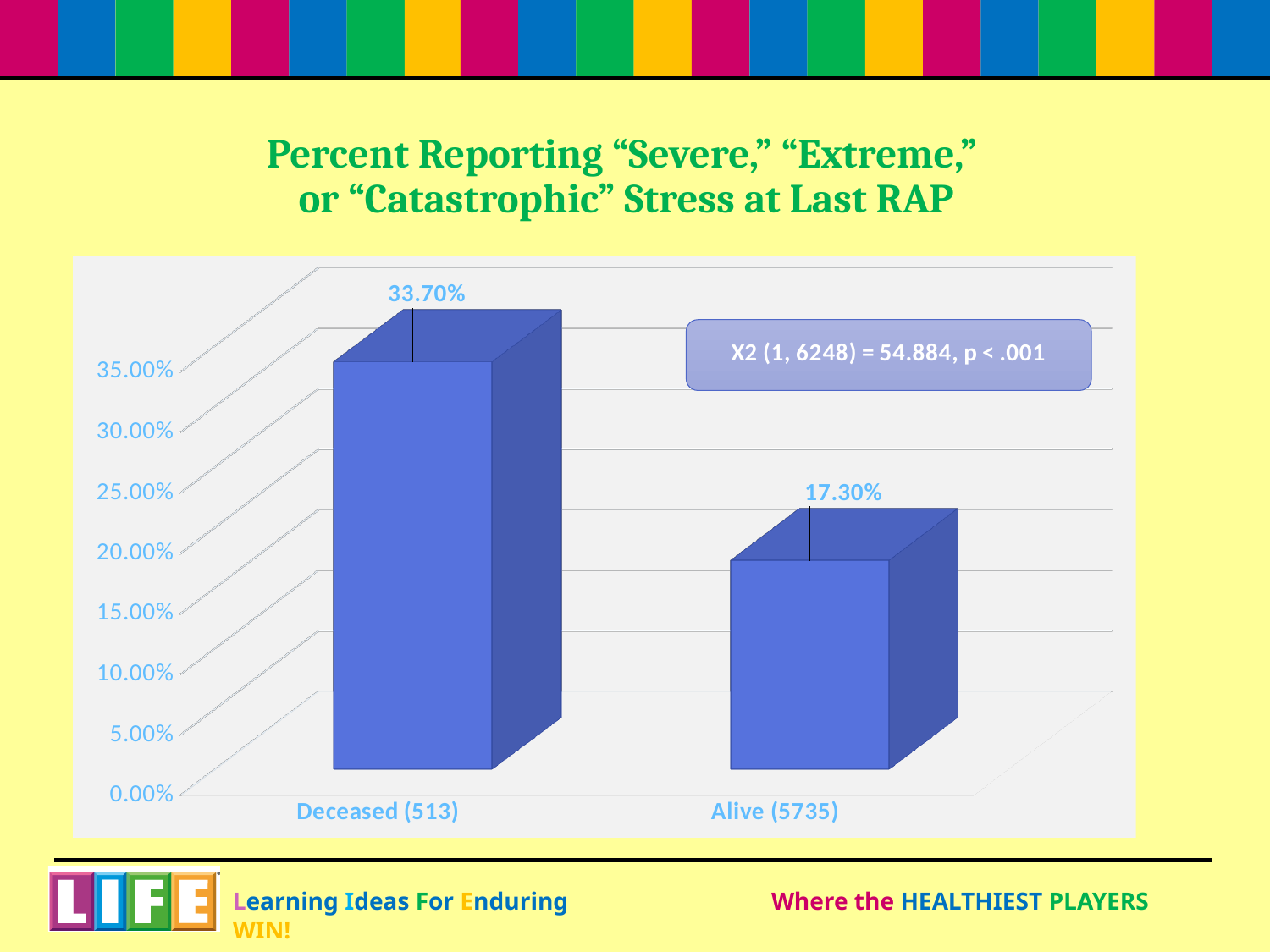
Which group has the lower percentage reporting severe, extreme, or catastrophic stress? Alive (5735) Is the value for Deceased (513) greater or less than 30.00%? greater What percentage is shown for the Alive (5735) group? 17.30% Is the value for Alive (5735) greater or less than 20.00%? less What percentage is shown for the Deceased (513) group? 33.70% Which group has the higher percentage reporting severe, extreme, or catastrophic stress? Deceased (513) Is the value for Deceased (513) larger or smaller than the value for Alive (5735)? larger What statistical result is shown in the box on the chart? X2 (1, 6248) = 54.884, p < .001 What is the title of the chart on the slide? Percent Reporting "Severe," "Extreme," or "Catastrophic" Stress at Last RAP How many categories are plotted on the chart? 2 What is the difference in percentage points between the Deceased (513) and Alive (5735) groups? 16.40% What kind of chart is shown on the slide? Bar chart